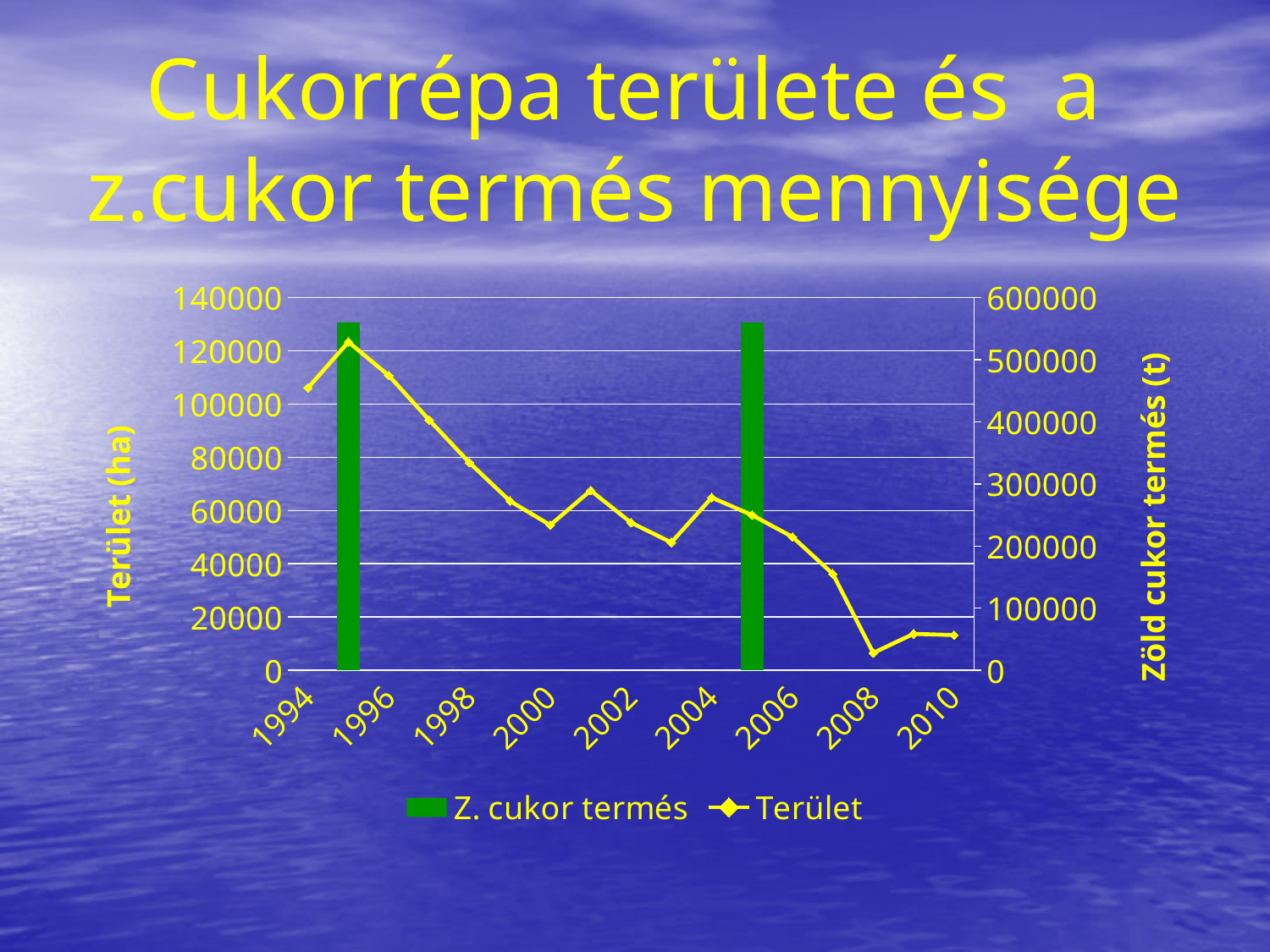
How many green bars (Z. cukor termés) are plotted on the chart? 2 In which year does the Terület line reach its lowest point? 2008 How many series does the legend list? 2 In which year does the Terület line reach its highest point? 1995 Is the Terület value for 1996 greater or less than 100000? greater Is the Z. cukor termés bar for 1995 greater or less than 500000 on the right axis? greater Does the Terület line overall rise or fall from 1994 to 2010? fall What are the two series named in the legend? Z. cukor termés and Terület What is the label of the left vertical axis? Terület (ha) What kind of chart is shown on the slide? A combined bar and line chart Is the Terület value for 2008 greater or less than 20000? less Which year has the larger Terület value, 2001 or 2003? 2001